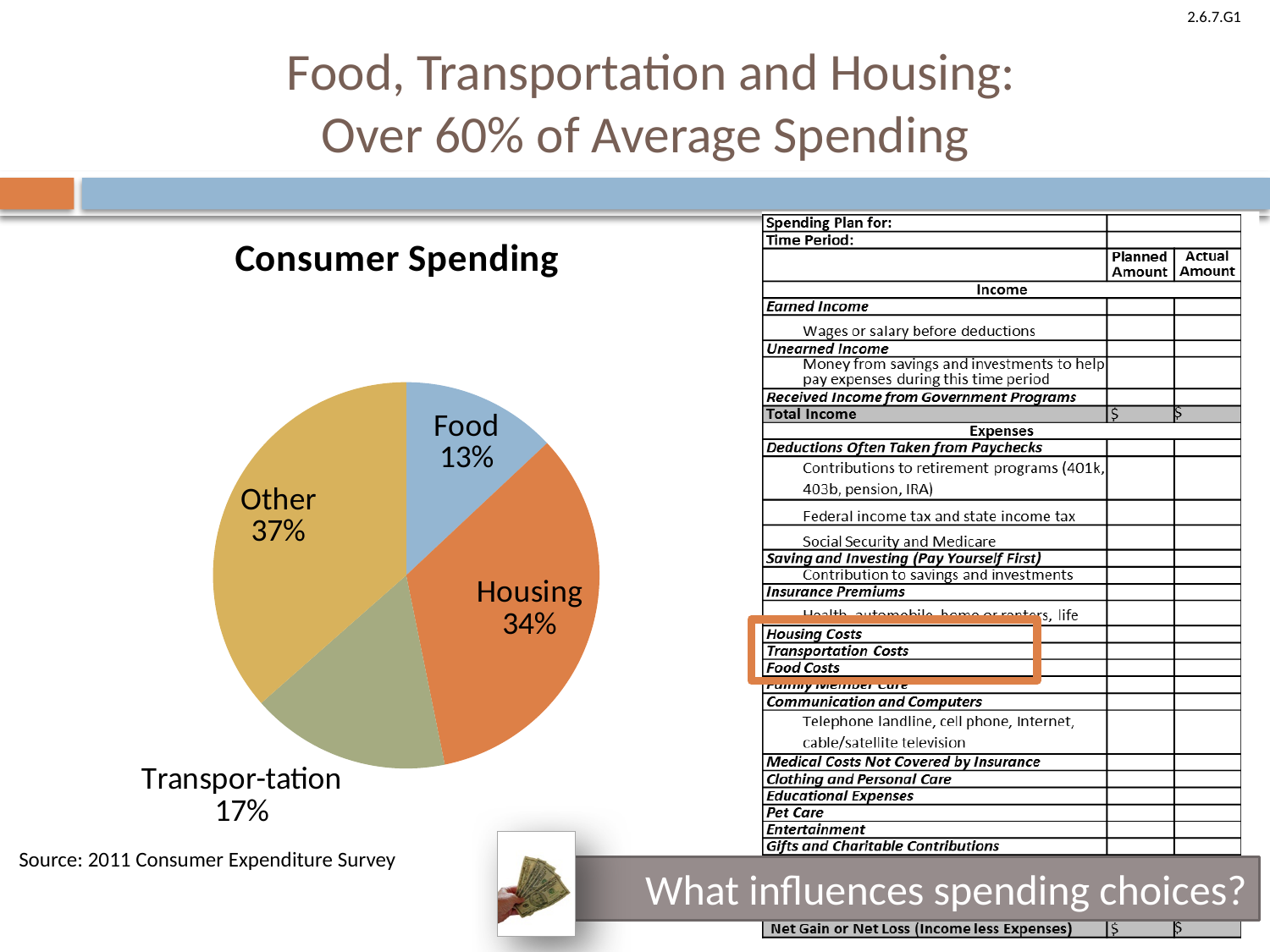
What is the difference in percentage points between Housing and Food? 21 How many categories are shown in the Consumer Spending pie chart? 4 What type of chart is the Consumer Spending chart? pie chart What percentage of consumer spending goes to Housing? 34% Which category has the smallest share of consumer spending? Food Which is larger, the share for Housing or the share for Transportation? Housing What percentage of consumer spending goes to Transportation? 17% What percentage of consumer spending goes to Food? 13% What is the combined share of Food, Transportation and Housing? 64% What percentage of consumer spending is labelled Other? 37% What is the title of the pie chart? Consumer Spending Which category has the largest share of consumer spending? Other